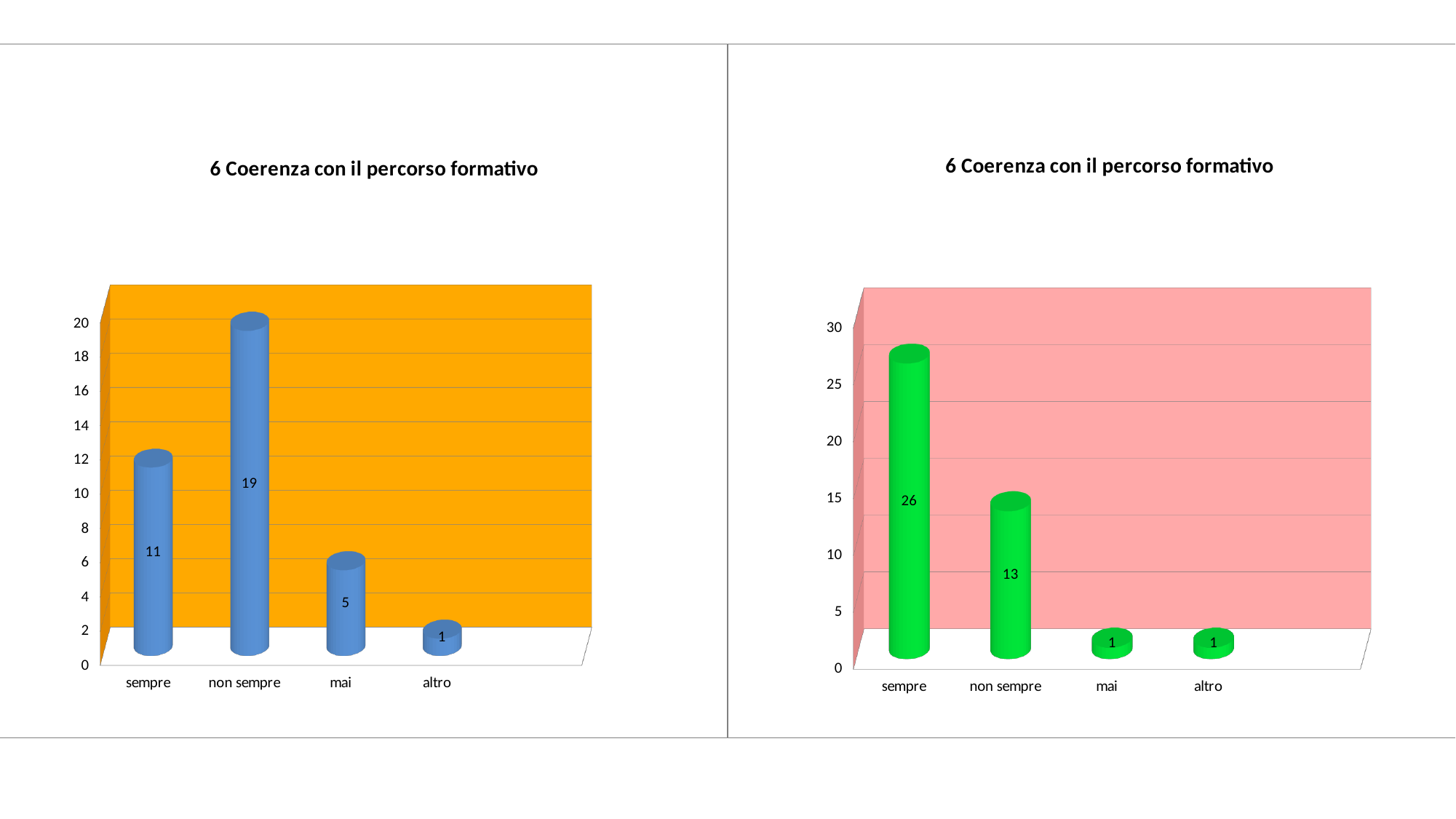
How many categories are shown in the right chart? 4 What kind of chart is the left chart? bar chart In the left chart, what is the value for "non sempre"? 19 In the left chart, what is the value for "sempre"? 11 In the right chart, which category has the highest value? sempre In the right chart, what is the difference between the values for "sempre" and "non sempre"? 13 In the right chart, what is the value for "sempre"? 26 In the left chart, which category has the lowest value? altro In the left chart, which is larger, the value for "mai" or the value for "altro"? mai In the right chart, what is the value for "non sempre"? 13 In the left chart, which category has the highest value? non sempre In the left chart, what is the difference between the values for "non sempre" and "sempre"? 8